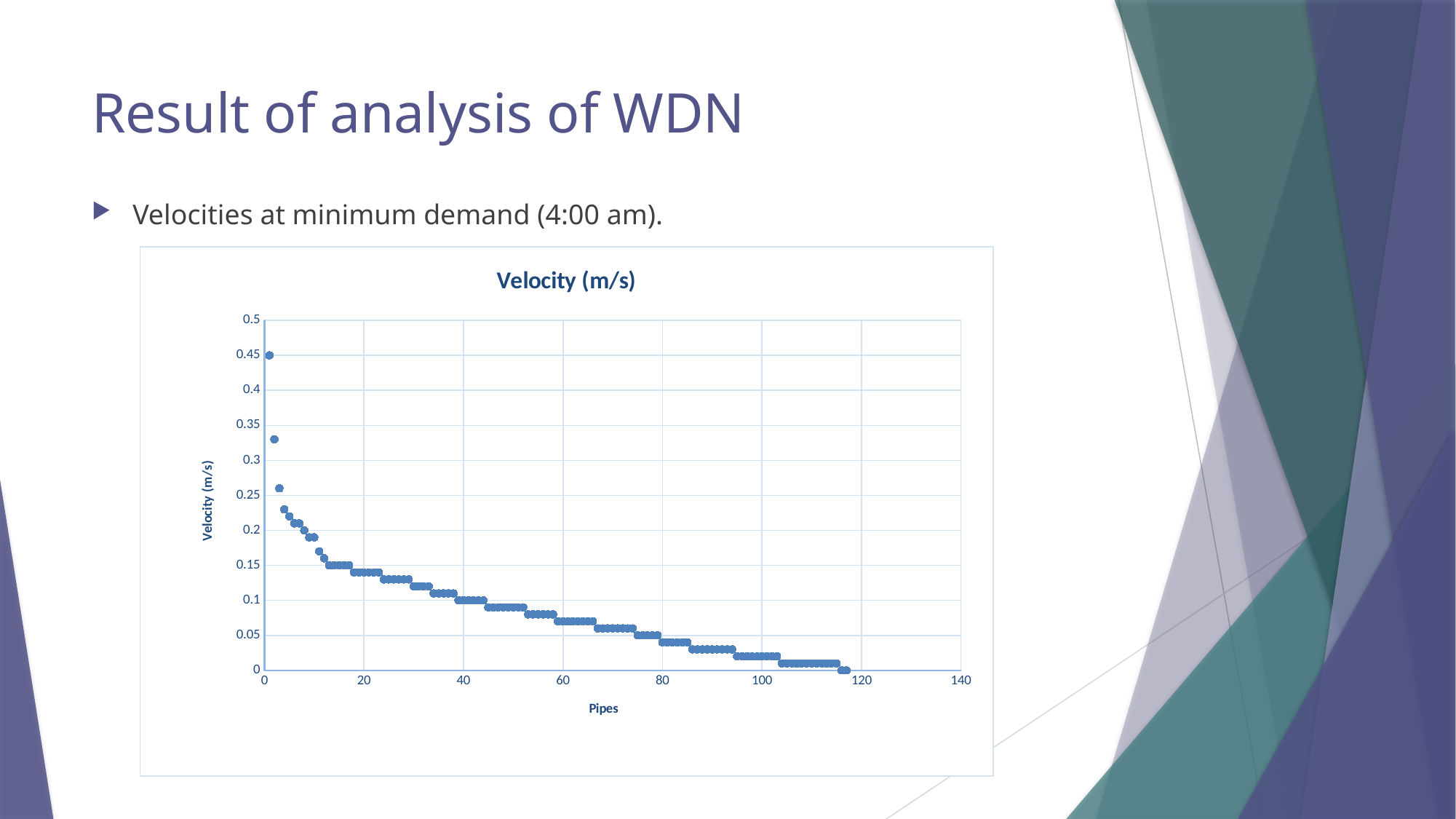
Is the velocity of the second pipe greater or less than 0.3 m/s? greater Is the velocity at pipe 40 greater or less than 0.15 m/s? less Is the velocity of the first (leftmost) pipe greater or less than 0.4 m/s? greater What is the title of the chart? Velocity (m/s) Which has the higher velocity, the first pipe or the pipe at x = 80? the first pipe What is the label of the x axis of the chart? Pipes What kind of chart is shown on the slide? scatter chart Where along the x axis is the highest velocity found: at the lowest pipe numbers or the highest pipe numbers? at the lowest pipe numbers Do the velocity values rise or fall as the pipe number increases along the x axis? fall